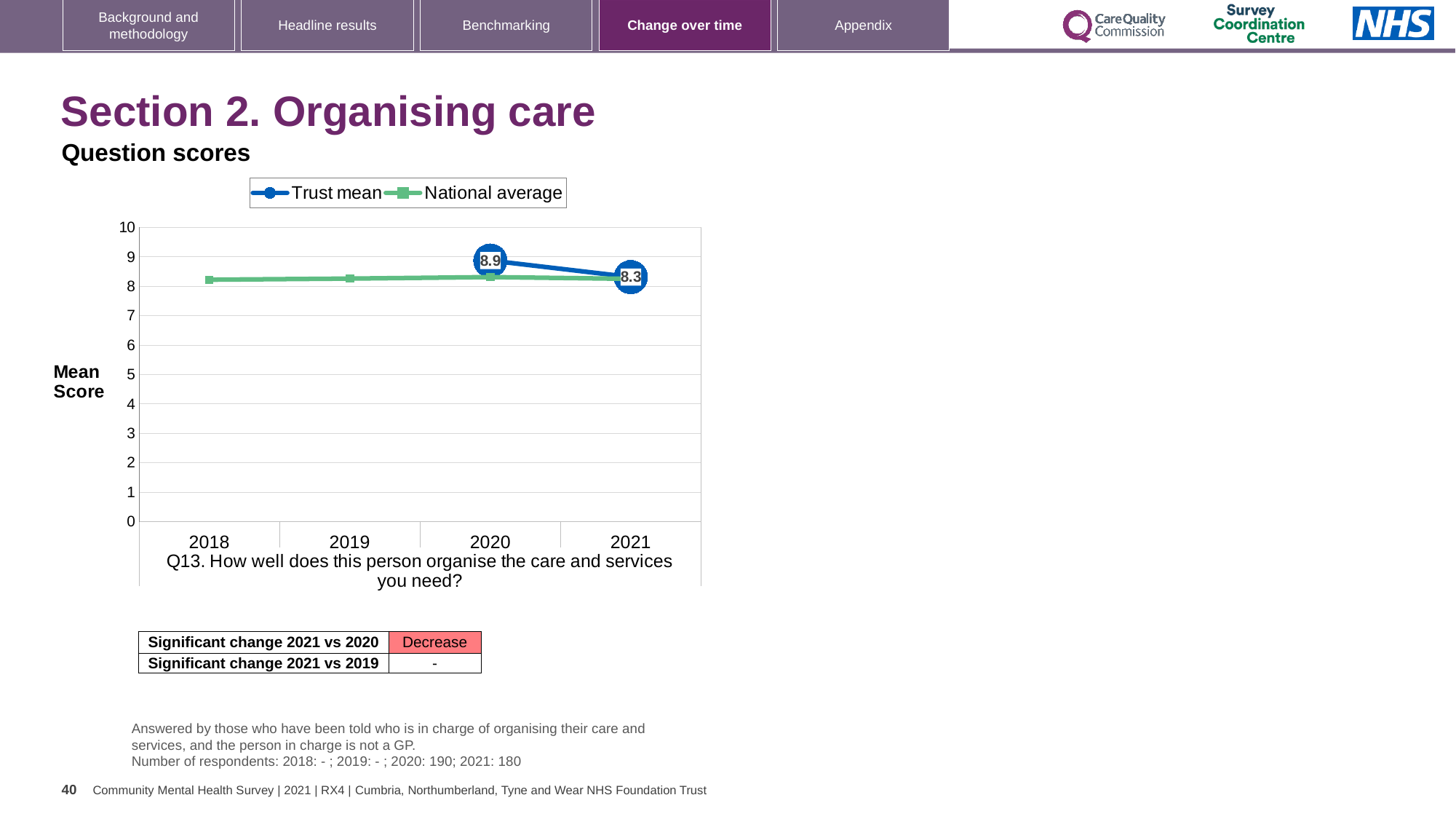
Which year has the higher Trust mean score, 2020 or 2021? 2020 Is the National average value for 2018 greater or less than 5? greater In 2020, which series is higher, Trust mean or National average? Trust mean By how much did the Trust mean score fall from 2020 to 2021? 0.6 How many series does the chart legend list? 2 Does the Trust mean rise or fall from 2020 to 2021? fall What is the Trust mean score for 2021? 8.3 What is the Trust mean score for 2020? 8.9 Is the National average value for 2019 greater or less than 7? greater What type of chart is shown on the slide? line chart What is the label on the y axis of the chart? Mean Score How many years are shown on the x axis of the chart? 4